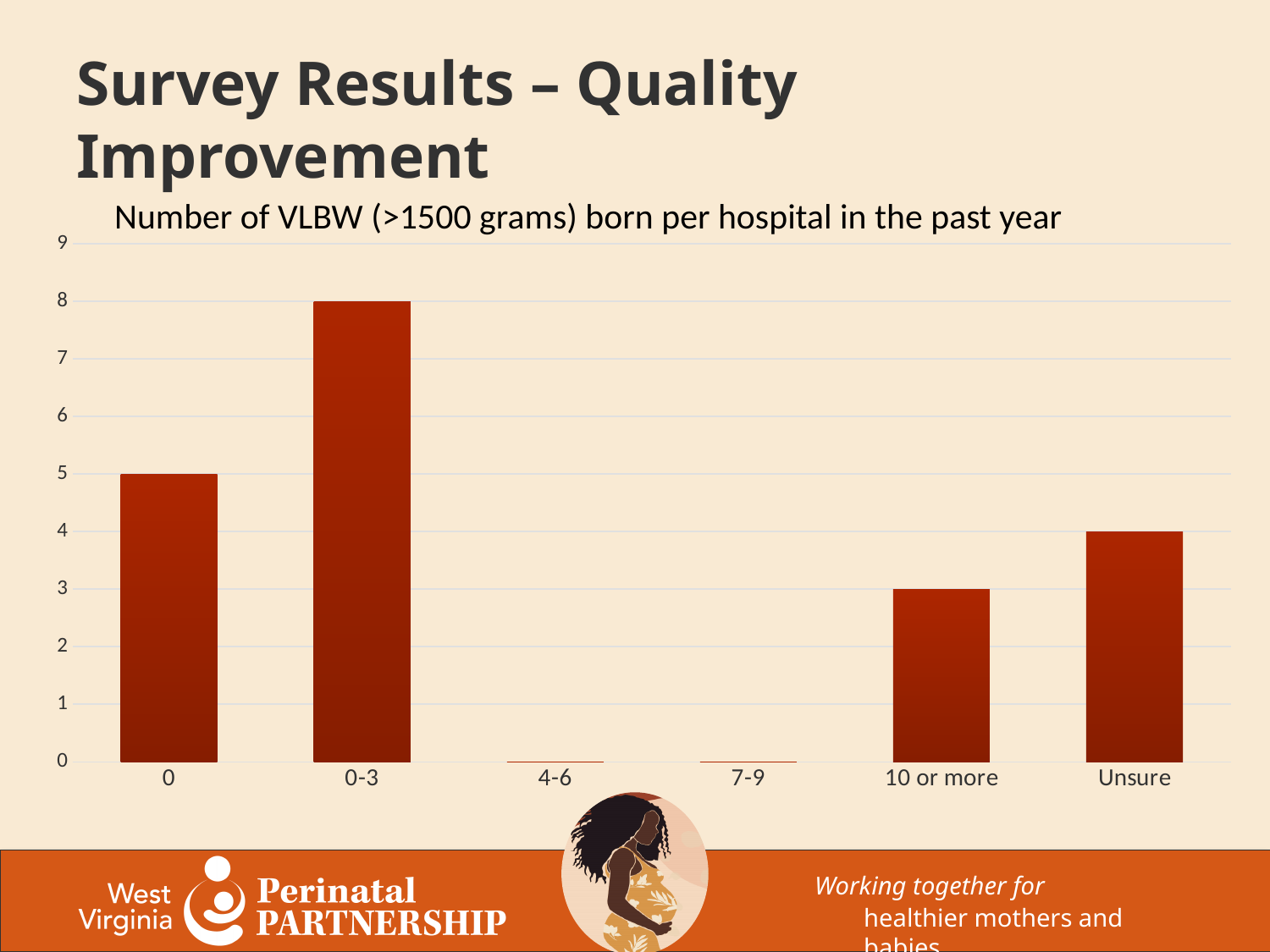
What is the value for the "0" category? 5 What is the value for the "0-3" category? 8 How many categories are shown on the x axis of the chart? 6 Is the value for "0-3" greater or less than 6? greater Which is larger, the value for "0" or the value for "Unsure"? 0 What kind of chart is shown on the slide? Bar chart What is the value for the "4-6" category? 0 What is the title of the chart? Number of VLBW (>1500 grams) born per hospital in the past year What is the difference between the value for "0-3" and the value for "0"? 3 What is the value for the "Unsure" category? 4 What is the value for the "10 or more" category? 3 Which category has the highest value? 0-3